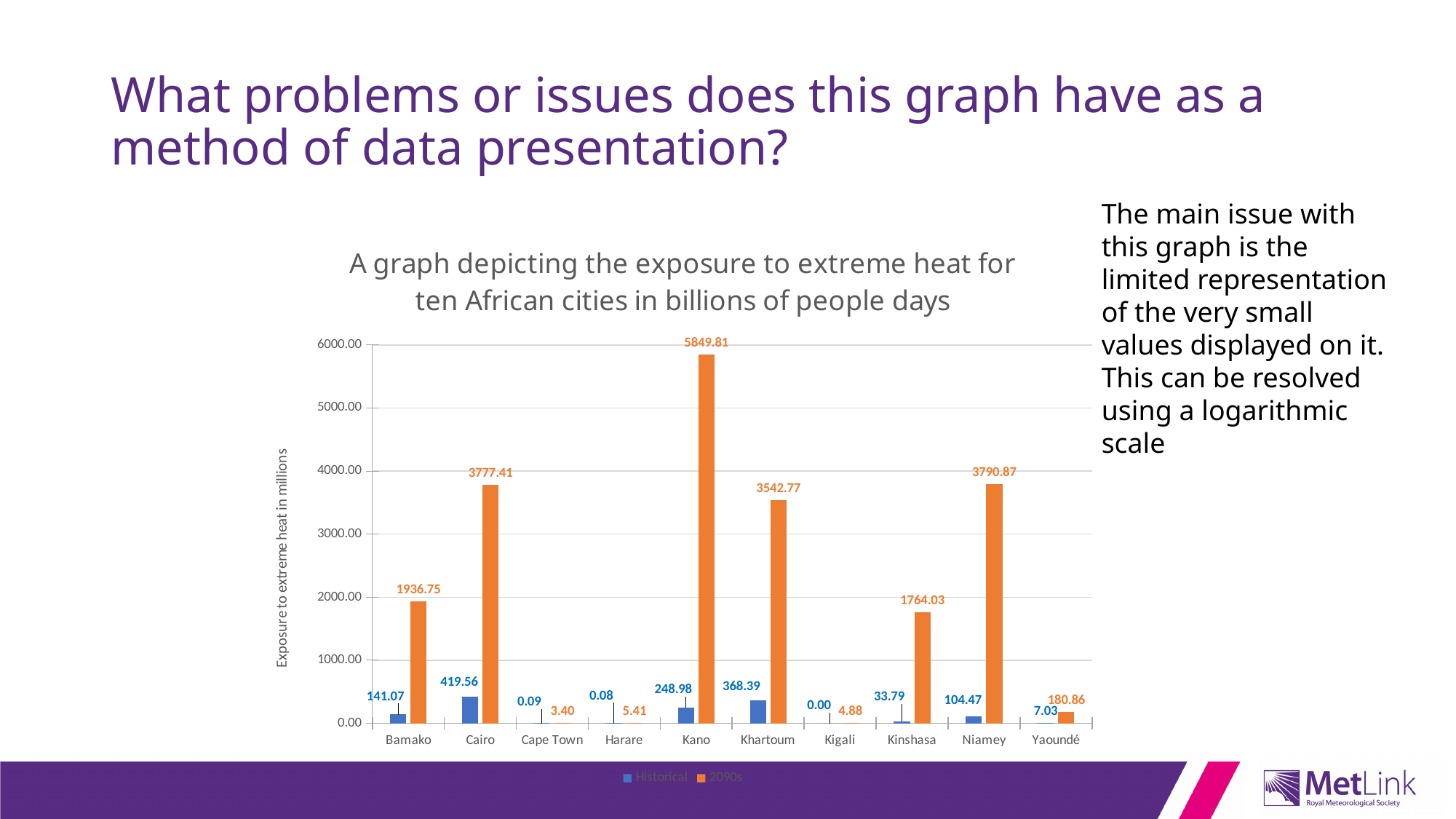
Which city has the highest 2090s value? Kano What is the difference between the 2090s and Historical values for Kano? 5600.83 Which city has the lowest Historical value? Kigali What is the label of the vertical axis? Exposure to extreme heat in millions What is the Historical value for Cairo? 419.56 Is the 2090s value for Khartoum greater or less than 3000.00? greater How many series does the legend list? 2 Which is larger, the 2090s value for Bamako or the 2090s value for Kinshasa? Bamako How many cities are shown on the x axis? 10 What kind of chart is shown on the slide? Bar chart What is the 2090s value for Yaoundé? 180.86 What is the 2090s value for Kano? 5849.81